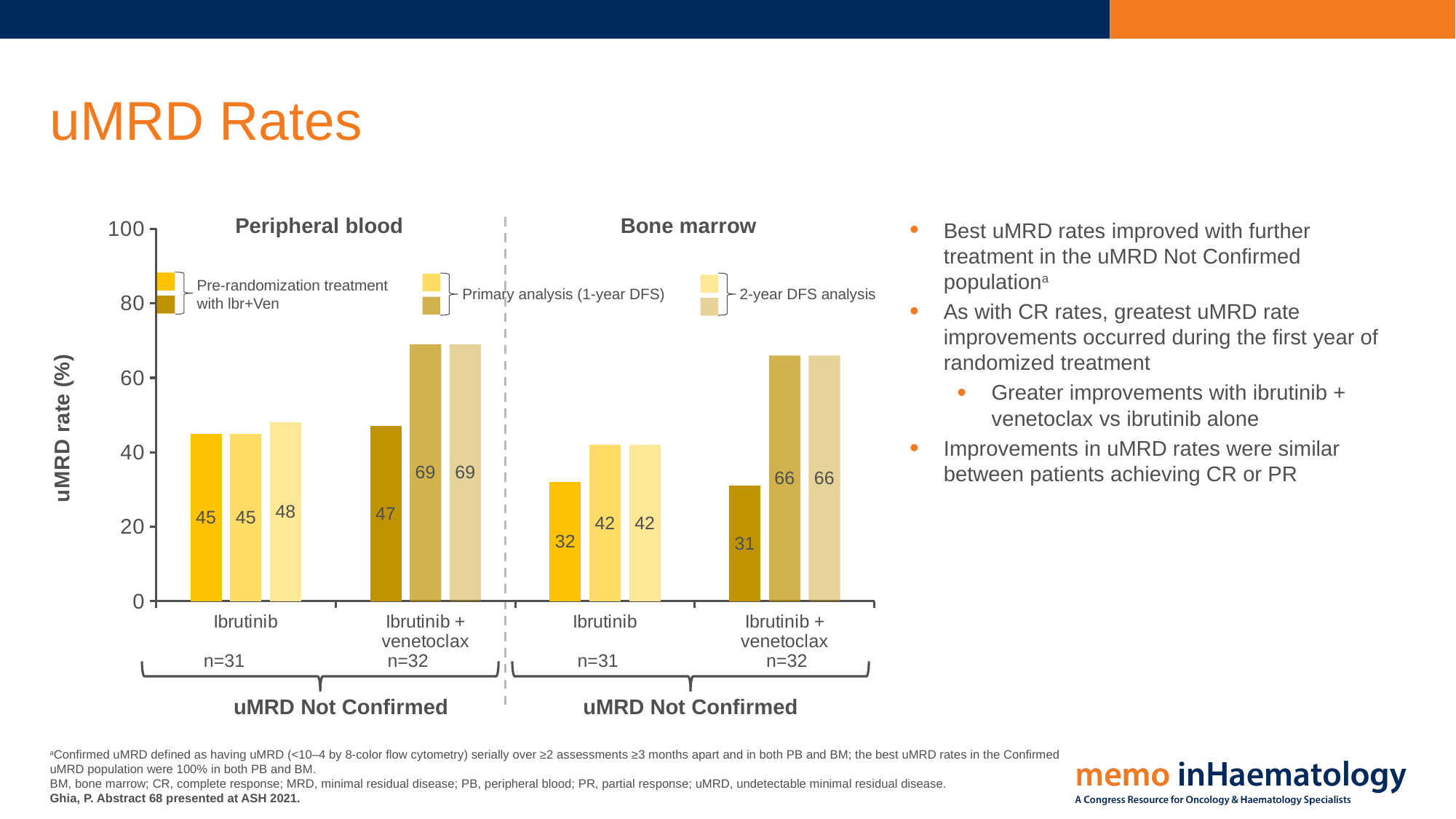
In the Bone marrow panel, what is the difference between the pre-randomization and primary analysis uMRD rates for Ibrutinib + venetoclax? 35 In the Peripheral blood panel, what is the uMRD rate for Ibrutinib at the 2-year DFS analysis? 48 In the Bone marrow panel, what is the pre-randomization uMRD rate for Ibrutinib? 32 In the Peripheral blood panel, what is the uMRD rate for Ibrutinib + venetoclax at the primary analysis (1-year DFS)? 69 Which bar in the whole chart has the highest uMRD rate? Ibrutinib + venetoclax in Peripheral blood (69) In the Bone marrow panel, what is the uMRD rate for Ibrutinib + venetoclax at the 2-year DFS analysis? 66 At the primary analysis (1-year DFS), is the Bone marrow uMRD rate for Ibrutinib higher or lower than the Peripheral blood uMRD rate for Ibrutinib? lower Which bar in the whole chart has the lowest uMRD rate? Ibrutinib + venetoclax pre-randomization in Bone marrow (31) How many series does the legend list? 3 What type of chart is shown on the slide? bar chart In the Peripheral blood panel, what is the difference between the 2-year DFS uMRD rate for Ibrutinib + venetoclax and for Ibrutinib? 21 What is the label of the y axis? uMRD rate (%)